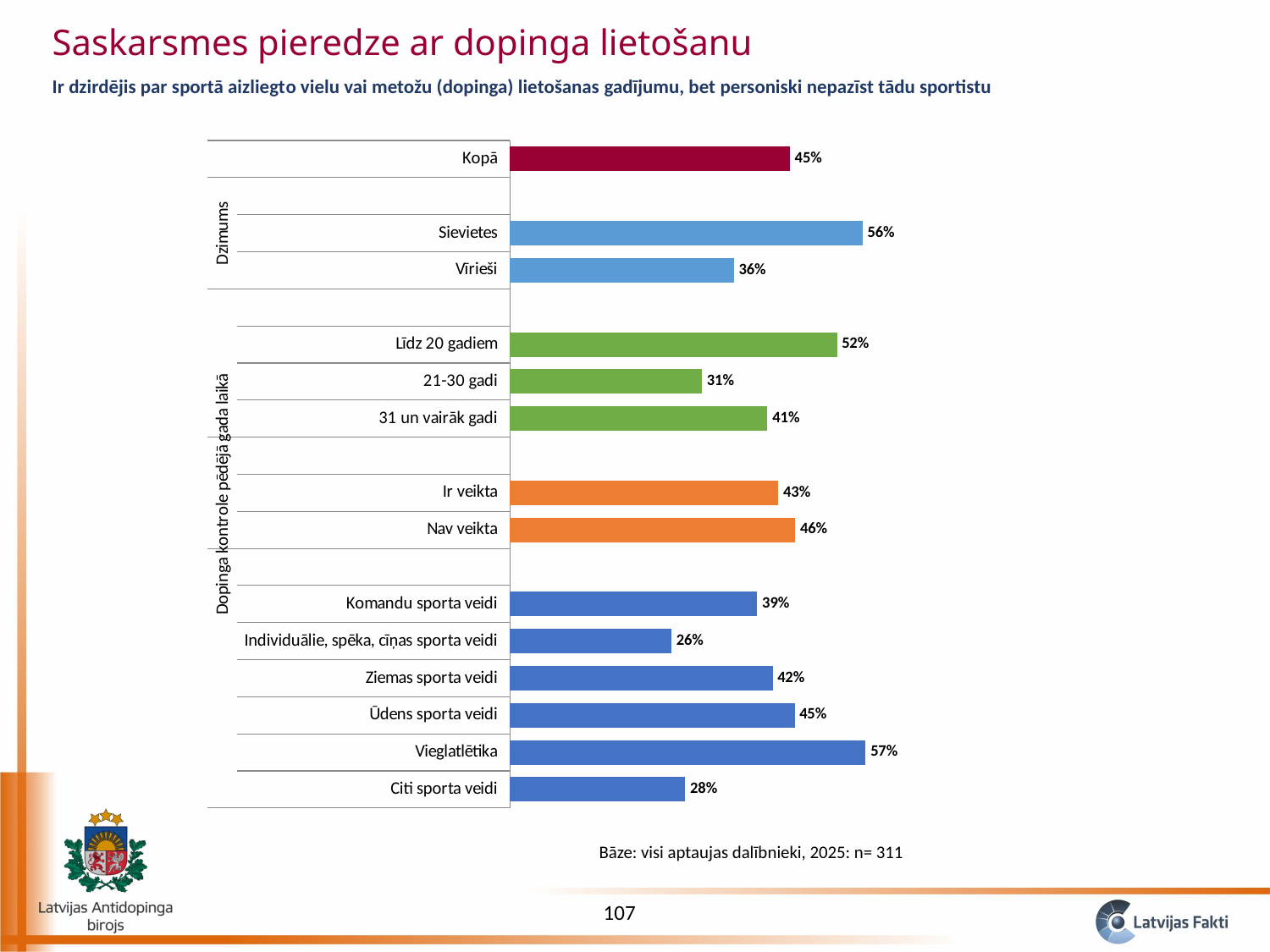
Which is larger, the value for Līdz 20 gadiem or the value for 31 un vairāk gadi? Līdz 20 gadiem How many bars are plotted in the chart? 14 What kind of chart is shown on the slide? Bar chart What is the difference between the values for Sievietes and Vīrieši? 20% Which category has the highest value? Vieglatlētika What is the value for 21-30 gadi? 31% What is the value for Kopā? 45% What is the value for Sievietes? 56% What is the value for Ziemas sporta veidi? 42% What is the value for Nav veikta? 46% Which category has the lowest value? Individuālie, spēka, cīņas sporta veidi What is the difference between the values for Ir veikta and Nav veikta? 3%